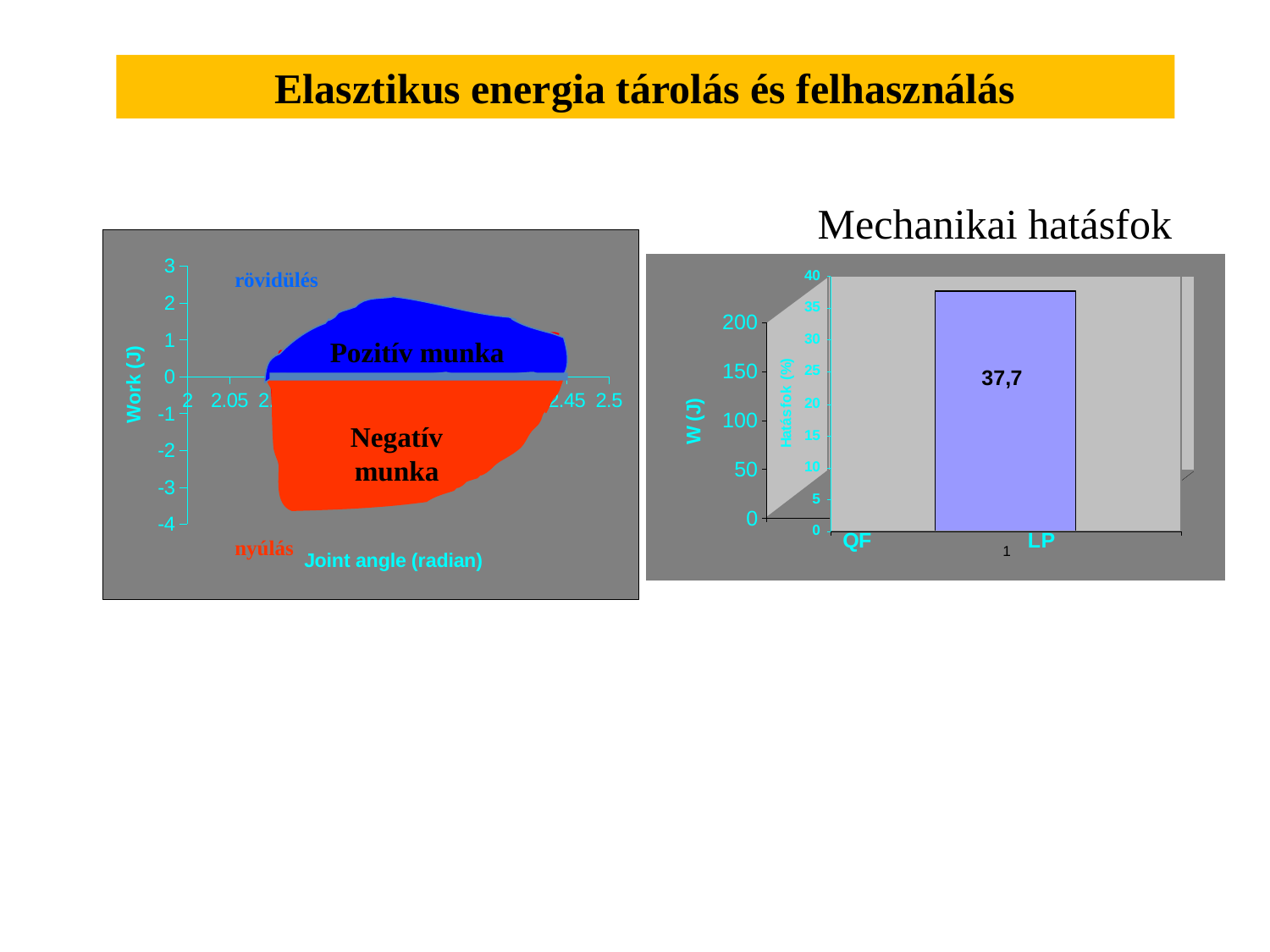
On the left chart, what is the y-axis label? Work (J) On the right chart (Mechanikai hatásfok), is the value of the bar greater or less than 30? greater On the right chart (Mechanikai hatásfok), what value is printed on the bar? 37,7 What kind of chart is the right chart (Mechanikai hatásfok)? bar chart On the right chart (Mechanikai hatásfok), how many bars are plotted? 1 On the left chart, what colour is the region labelled "Pozitív munka"? blue What is the title of the right chart? Mechanikai hatásfok On the right chart (Mechanikai hatásfok), is the value of the bar greater or less than 40? less